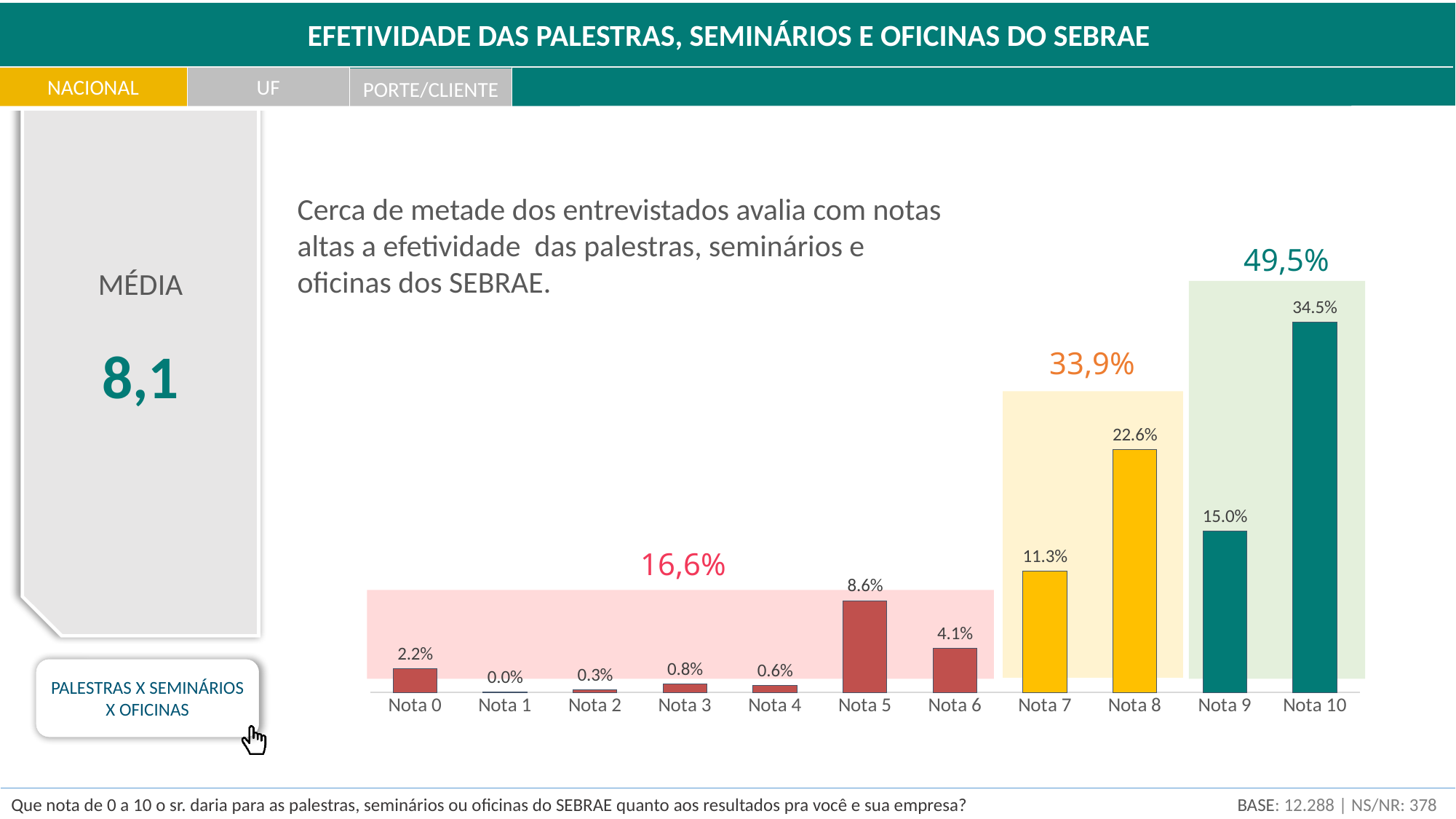
Which is larger, the value for Nota 7 or the value for Nota 6? Nota 7 What is the value for Nota 1? 0.0% What is the difference between the values for Nota 10 and Nota 9? 19.5% How many categories are shown on the x axis? 11 What is the value for Nota 5? 8.6% What is the value for Nota 8? 22.6% What is the combined share shown above the green-shaded group (Nota 9 and Nota 10)? 49,5% Which category has the lowest value? Nota 1 What is the average (MÉDIA) shown on the left of the slide? 8,1 Which category has the highest value? Nota 10 What is the value for Nota 10? 34.5% What kind of chart is shown on the slide? Bar chart